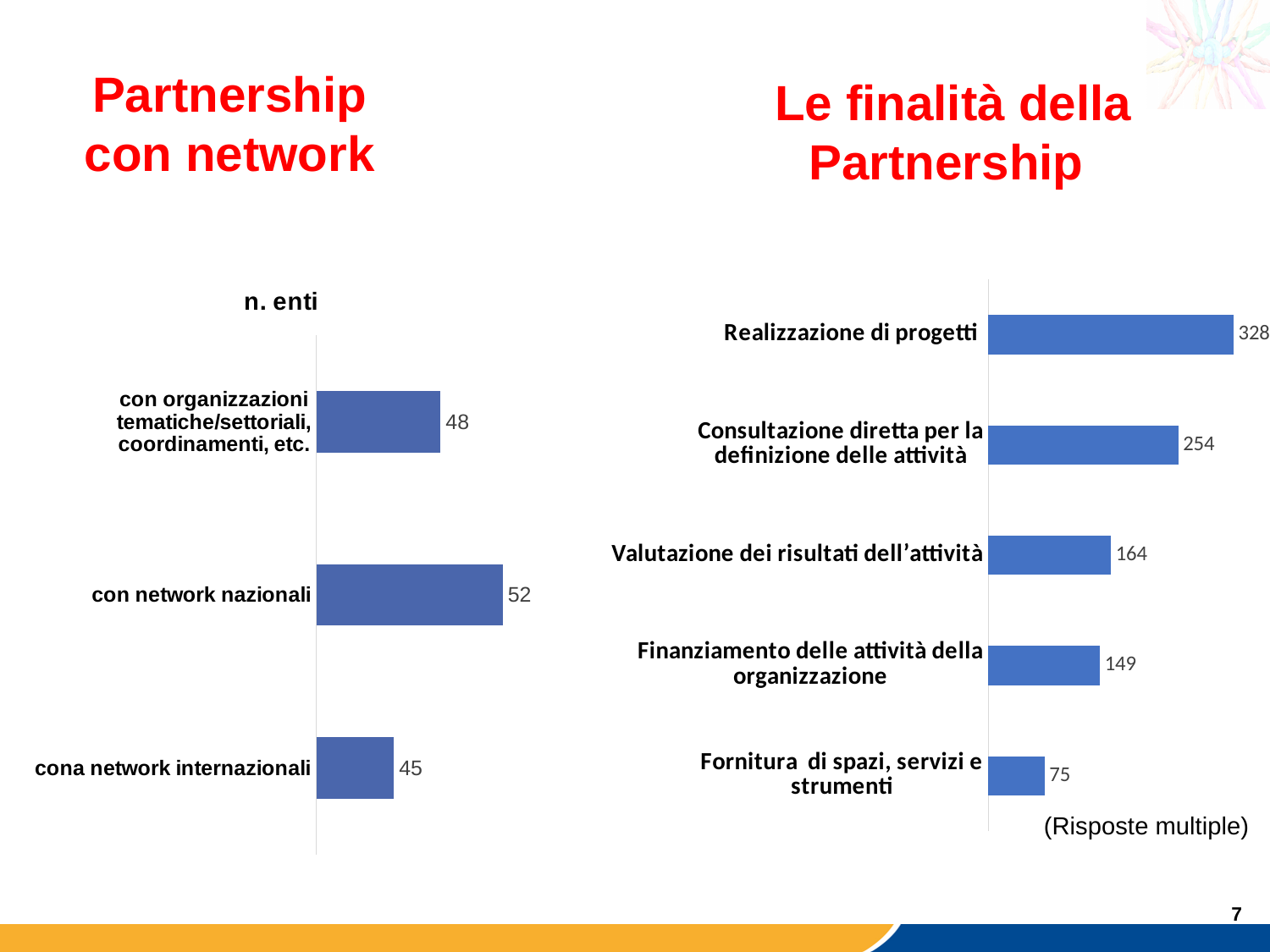
In the 'Partnership con network' chart on the left, what is the label shown above the chart? n. enti In the 'Partnership con network' chart on the left, which category has the lowest value? cona network internazionali In the 'Le finalità della Partnership' chart on the right, how many categories are shown? 5 In the 'Partnership con network' chart on the left, what is the value for 'con network nazionali'? 52 What type of chart is the 'Le finalità della Partnership' chart on the right? Bar chart In the 'Le finalità della Partnership' chart on the right, what is the value for 'Realizzazione di progetti'? 328 In the 'Le finalità della Partnership' chart on the right, which is larger: 'Valutazione dei risultati dell'attività' or 'Finanziamento delle attività della organizzazione'? Valutazione dei risultati dell'attività In the 'Partnership con network' chart on the left, what is the difference between 'con network nazionali' and 'cona network internazionali'? 7 In the 'Le finalità della Partnership' chart on the right, which category has the highest value? Realizzazione di progetti In the 'Partnership con network' chart on the left, how many categories are shown? 3 In the 'Le finalità della Partnership' chart on the right, what is the value for 'Fornitura di spazi, servizi e strumenti'? 75 In the 'Le finalità della Partnership' chart on the right, what is the difference between 'Realizzazione di progetti' and 'Consultazione diretta per la definizione delle attività'? 74